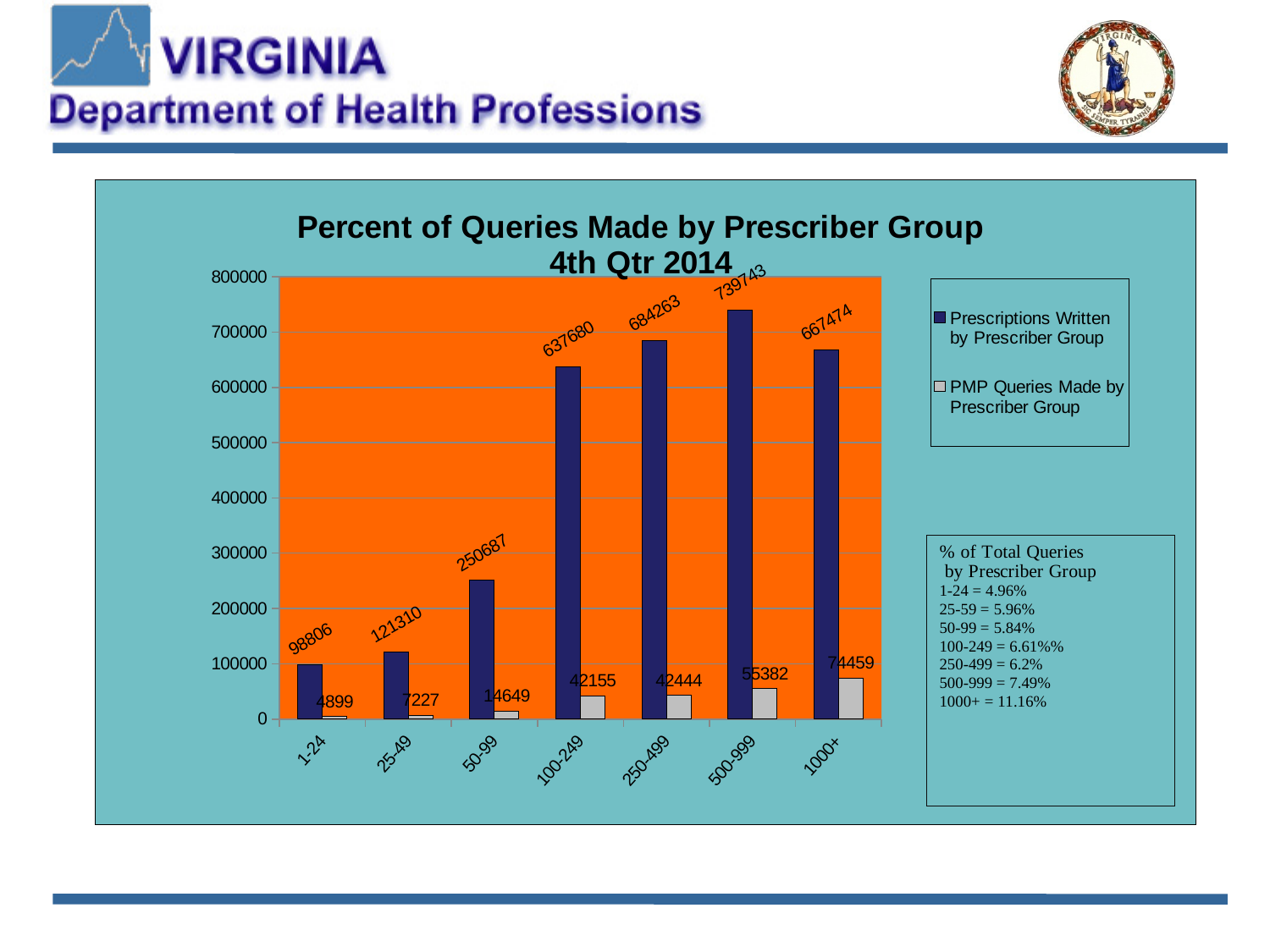
Which is larger: Prescriptions Written for the 250-499 group or for the 1000+ group? 250-499 How many prescriber groups are shown on the x axis? 7 What is the title of the chart? Percent of Queries Made by Prescriber Group 4th Qtr 2014 How many series does the legend list? 2 Which prescriber group has the lowest value for PMP Queries Made by Prescriber Group? 1-24 What kind of chart is shown on the slide? bar chart What is the value of PMP Queries Made by Prescriber Group for the 1000+ group? 74459 What is the value of Prescriptions Written by Prescriber Group for the 500-999 group? 739743 What is the difference between Prescriptions Written and PMP Queries Made for the 100-249 group? 595525 What is the value of PMP Queries Made by Prescriber Group for the 50-99 group? 14649 Is the value of Prescriptions Written by Prescriber Group for the 50-99 group greater or less than 300000? less Which prescriber group has the highest value for Prescriptions Written by Prescriber Group? 500-999